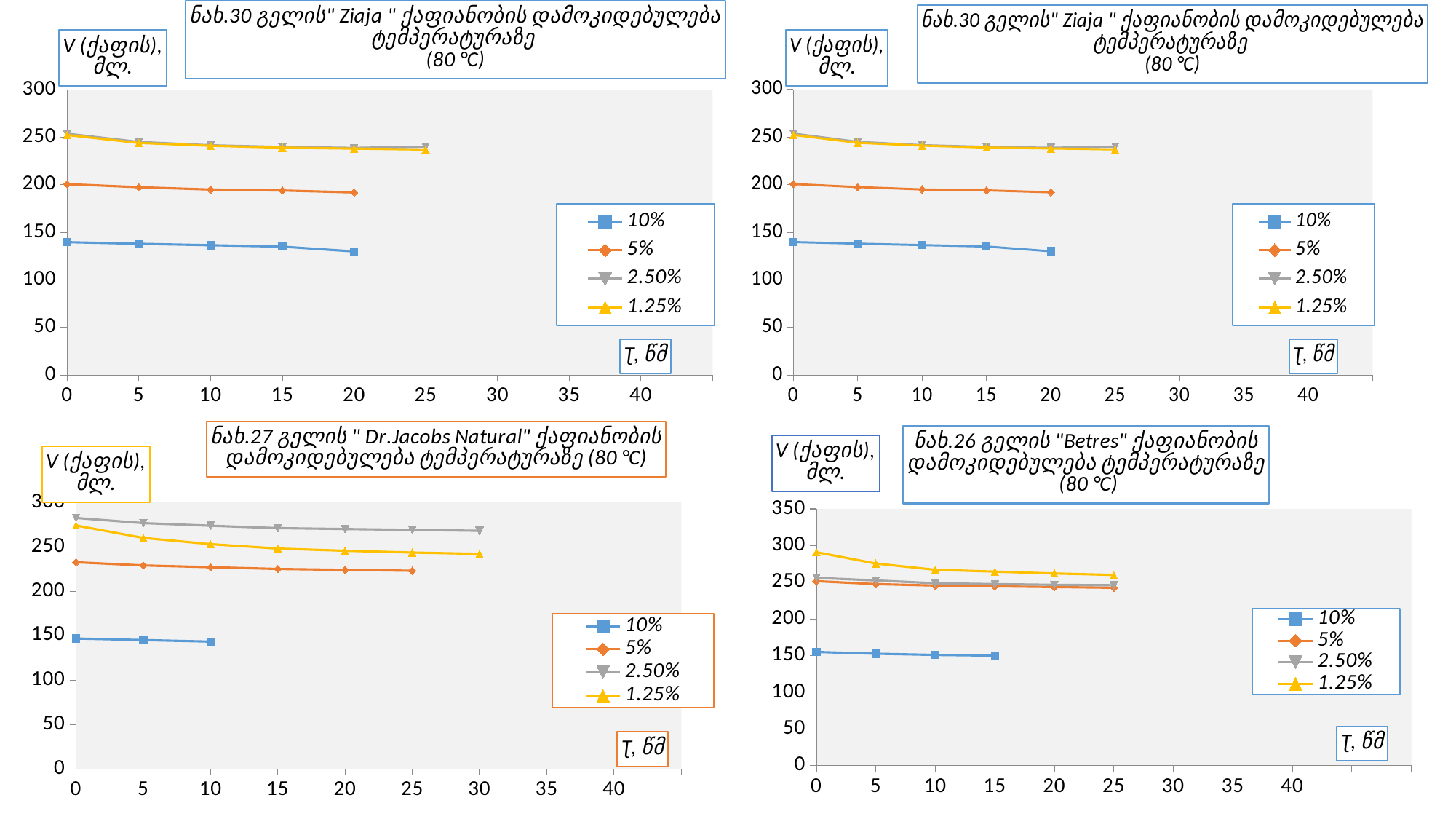
In the top-left chart (Ziaja), which series has the lowest values throughout? 10% In the bottom-left chart (Dr.Jacobs Natural), which series has the highest value at τ = 0? 2.50% In the bottom-right chart (Betres), what is the highest tick value shown on the vertical axis? 350 In the top-right chart (Ziaja), is the value of the 5% series at τ = 20 greater or less than 150? greater In the bottom-left chart (Dr.Jacobs Natural), is the value of the 10% series at τ = 0 greater or less than 200? less In the bottom-right chart (Betres), how many data points does the 10% series have? 4 In the top-left chart (Ziaja), does the 10% series rise or fall as τ increases? fall In the bottom-right chart (Betres), is the value of the 1.25% series at τ = 0 greater or less than 250? greater What kind of chart is the bottom-left chart (Dr.Jacobs Natural)? line chart In the bottom-right chart (Betres), how many series does the legend list? 4 In the bottom-right chart (Betres), which series has the larger value at τ = 0: 1.25% or 10%? 1.25% In the bottom-left chart (Dr.Jacobs Natural), how many data points does the 10% series have? 3